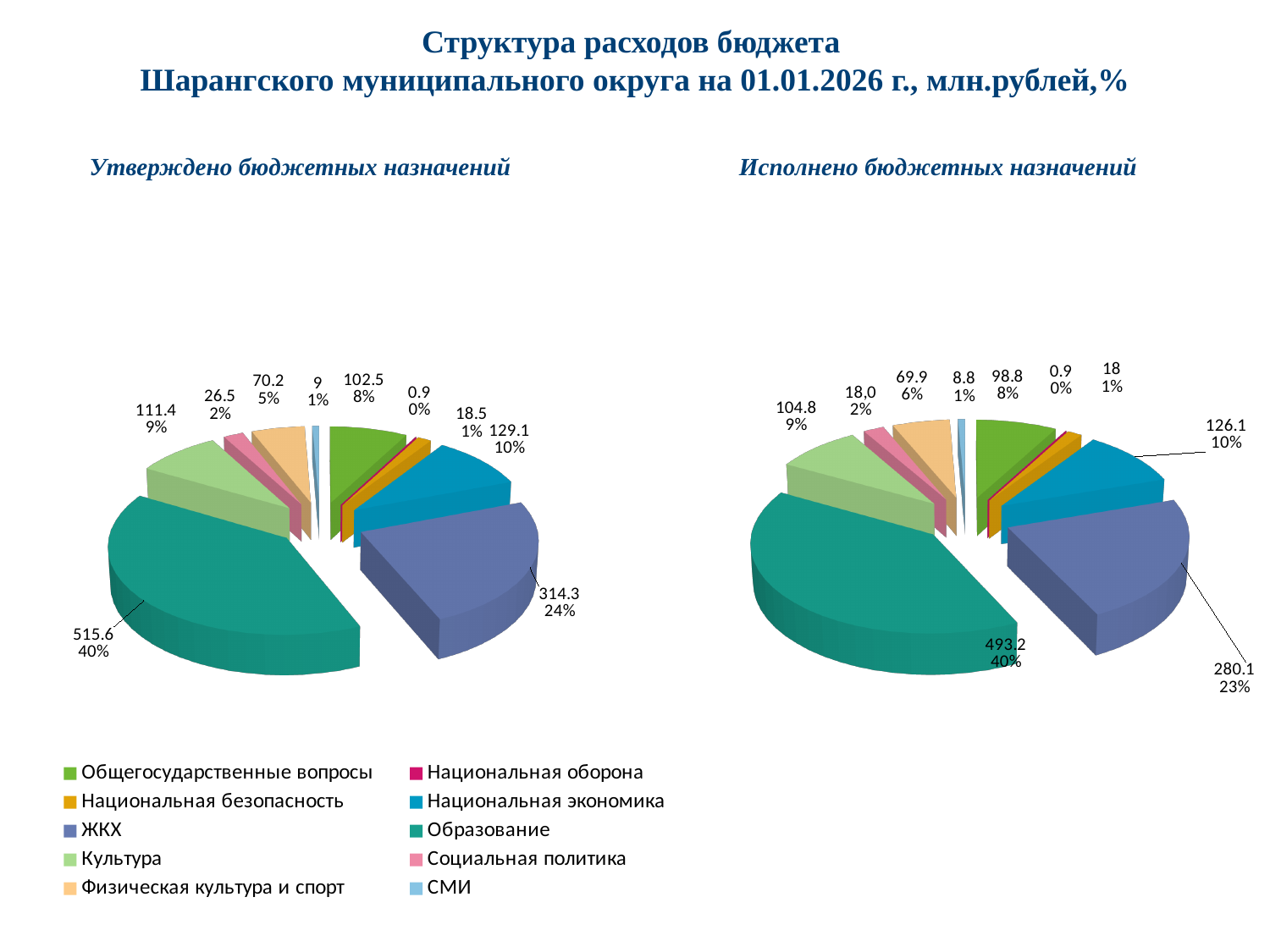
In the chart 'Утверждено бюджетных назначений', what value is shown for Национальная экономика? 129.1 How many categories does the legend list? 10 In the chart 'Утверждено бюджетных назначений', what value is shown for Образование? 515.6 In the chart 'Утверждено бюджетных назначений', which category has the largest slice? Образование In the chart 'Исполнено бюджетных назначений', what share of the pie does Образование take? 40% In the chart 'Утверждено бюджетных назначений', which is larger: Культура or Физическая культура и спорт? Культура What is the difference between the ЖКХ value in 'Утверждено бюджетных назначений' (314.3) and in 'Исполнено бюджетных назначений' (280.1)? 34.2 In the chart 'Исполнено бюджетных назначений', which category has the smallest slice? Национальная оборона In the chart 'Исполнено бюджетных назначений', what value is shown for ЖКХ? 280.1 In the chart 'Утверждено бюджетных назначений', what share of the pie does ЖКХ take? 24% What type of chart is used on the slide? Pie chart In the chart 'Исполнено бюджетных назначений', what value is shown for Общегосударственные вопросы? 98.8